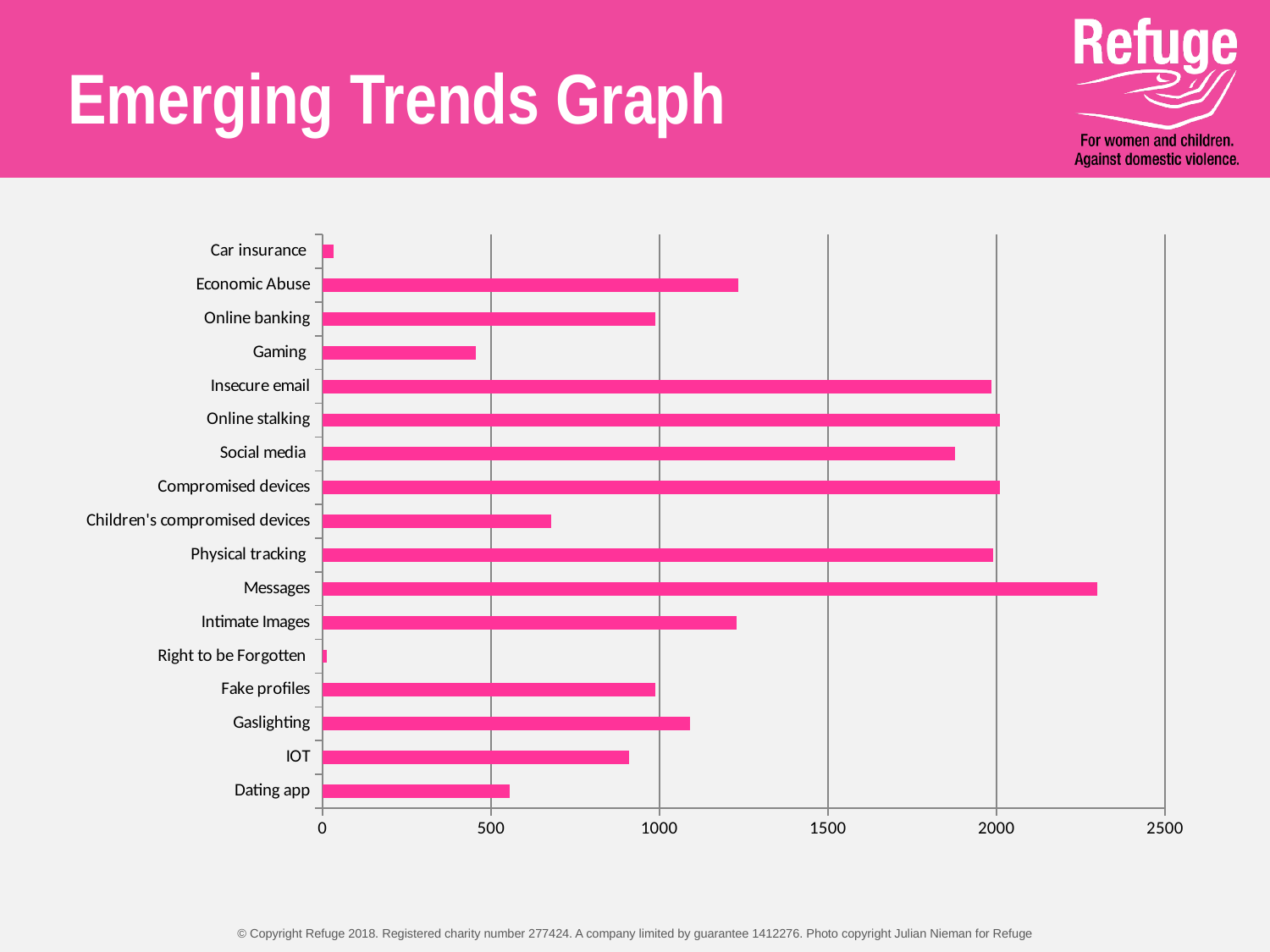
Is the value for IOT greater or less than 1000? less Is the value for Social media greater or less than 2000? less Which has the larger value, Economic Abuse or Gaming? Economic Abuse Is the value for Gaming greater or less than 500? less Which category has the highest value in the chart? Messages What colour are the bars in the chart? Pink Which category has the lowest value in the chart? Right to be Forgotten What kind of chart is shown on the slide? Bar chart How many categories are plotted in the chart? 17